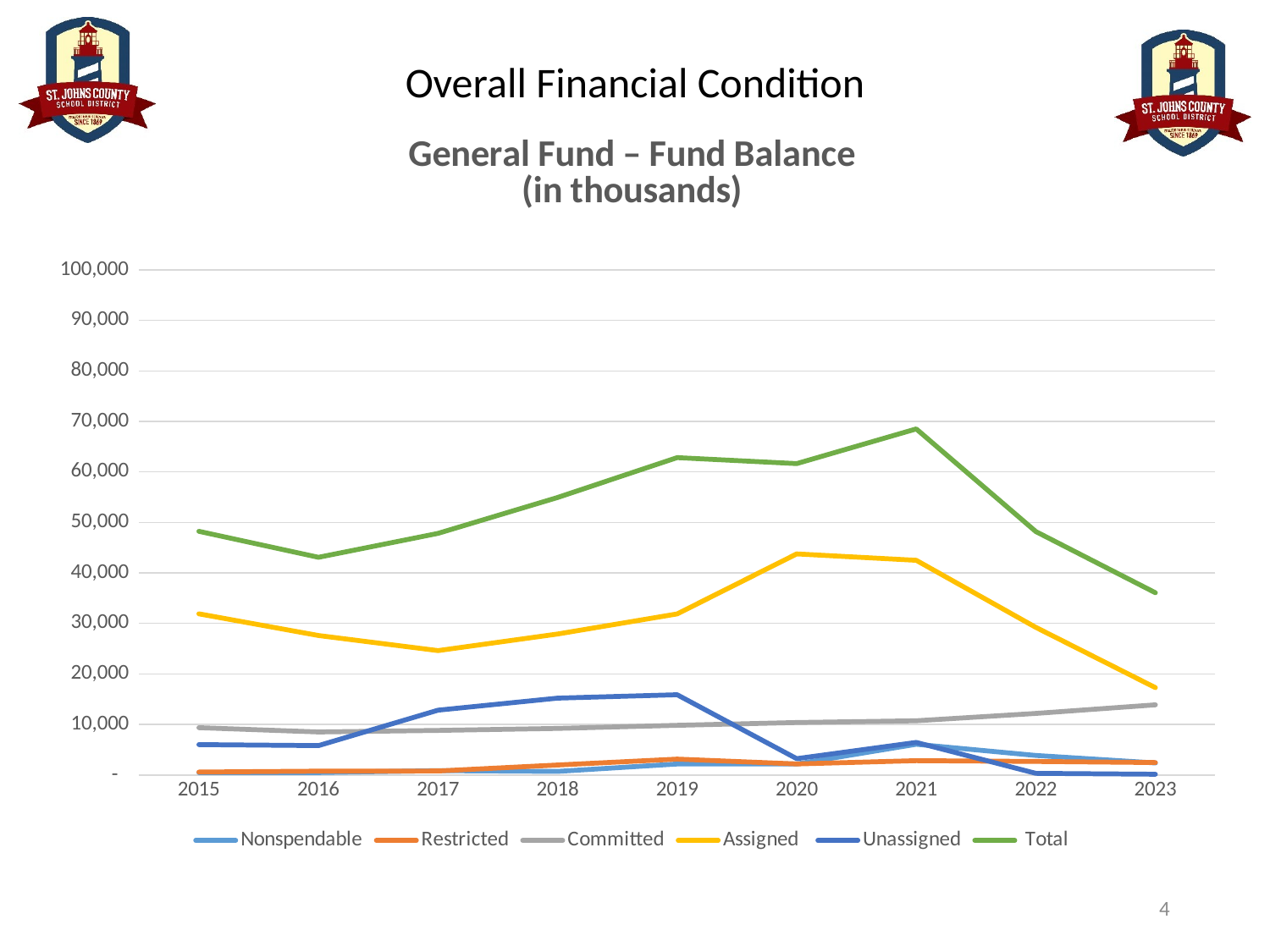
In which year is the Total series highest? 2021 Is the Assigned value for 2023 greater or less than 20,000? less Which year has the larger Total value, 2016 or 2019? 2019 What colour is the line for the Total series? green How many series does the legend list? 6 What kind of chart is shown on the slide? line chart Does the Total series rise or fall from 2021 to 2023? fall How many years are shown on the x axis? 9 In which year is the Total series lowest? 2023 In which year is the Assigned series highest? 2020 Is the Total value for 2021 greater or less than 60,000? greater Does the Committed series generally rise or fall from 2015 to 2023? rise